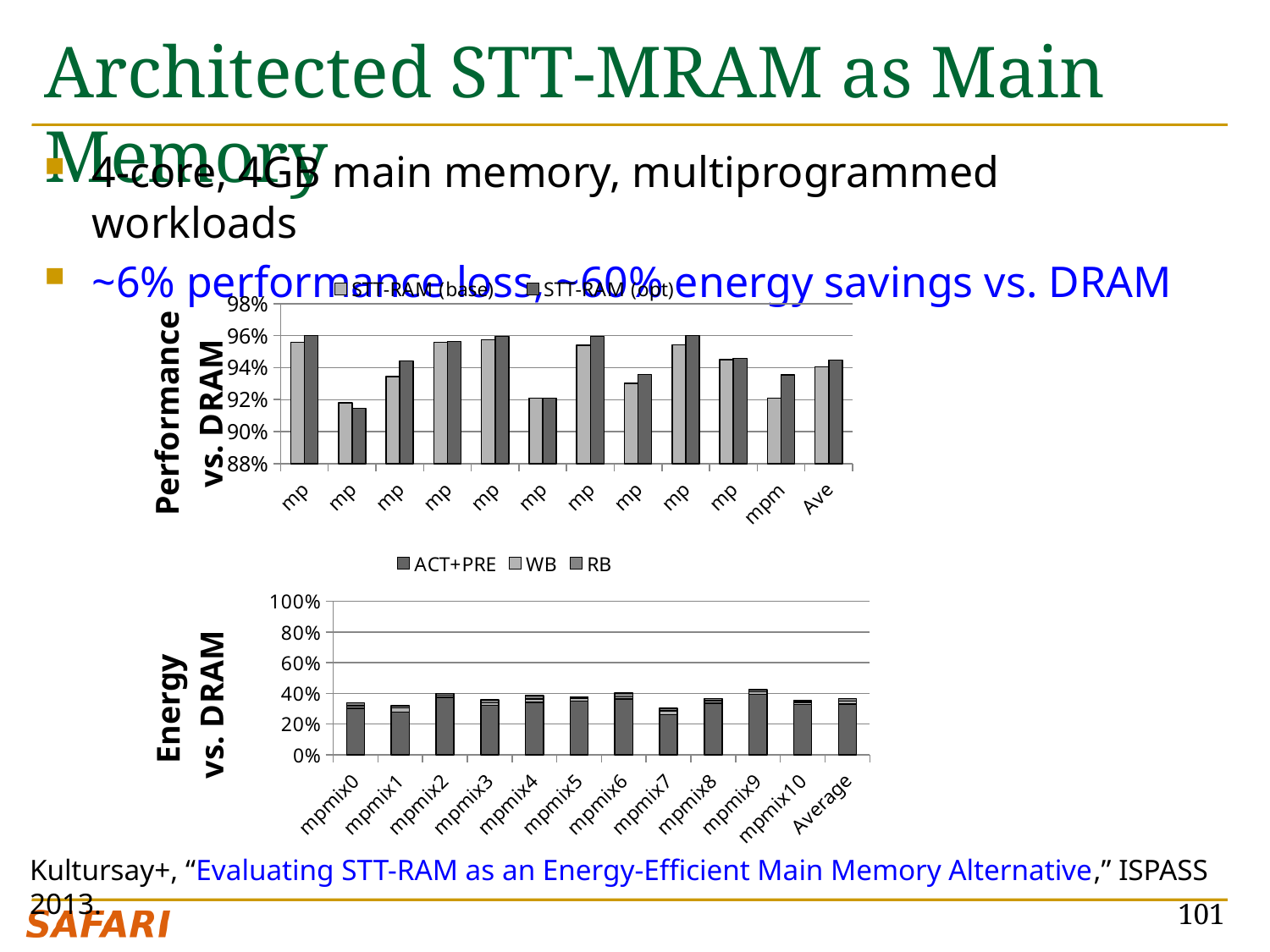
In the bottom chart (Energy vs. DRAM), is the total stacked value for mpmix7 greater or less than 20%? greater In the top chart (Performance vs. DRAM), is the STT-RAM (base) value for Ave greater or less than 96%? less How many series does the legend of the bottom chart (Energy vs. DRAM) list? 3 In the bottom chart (Energy vs. DRAM), is the total stacked value for Average greater or less than 60%? less How many series does the legend of the top chart (Performance vs. DRAM) list? 2 What are the legend entries of the bottom chart (Energy vs. DRAM)? ACT+PRE, WB, RB How many categories are shown on the x axis of the bottom chart (Energy vs. DRAM)? 12 In the bottom chart (Energy vs. DRAM), which has the taller stacked bar, mpmix2 or mpmix1? mpmix2 In the bottom chart (Energy vs. DRAM), which has the taller stacked bar, mpmix9 or mpmix7? mpmix9 What kind of chart is the top chart (Performance vs. DRAM)? bar chart What kind of chart is the bottom chart (Energy vs. DRAM)? stacked bar chart